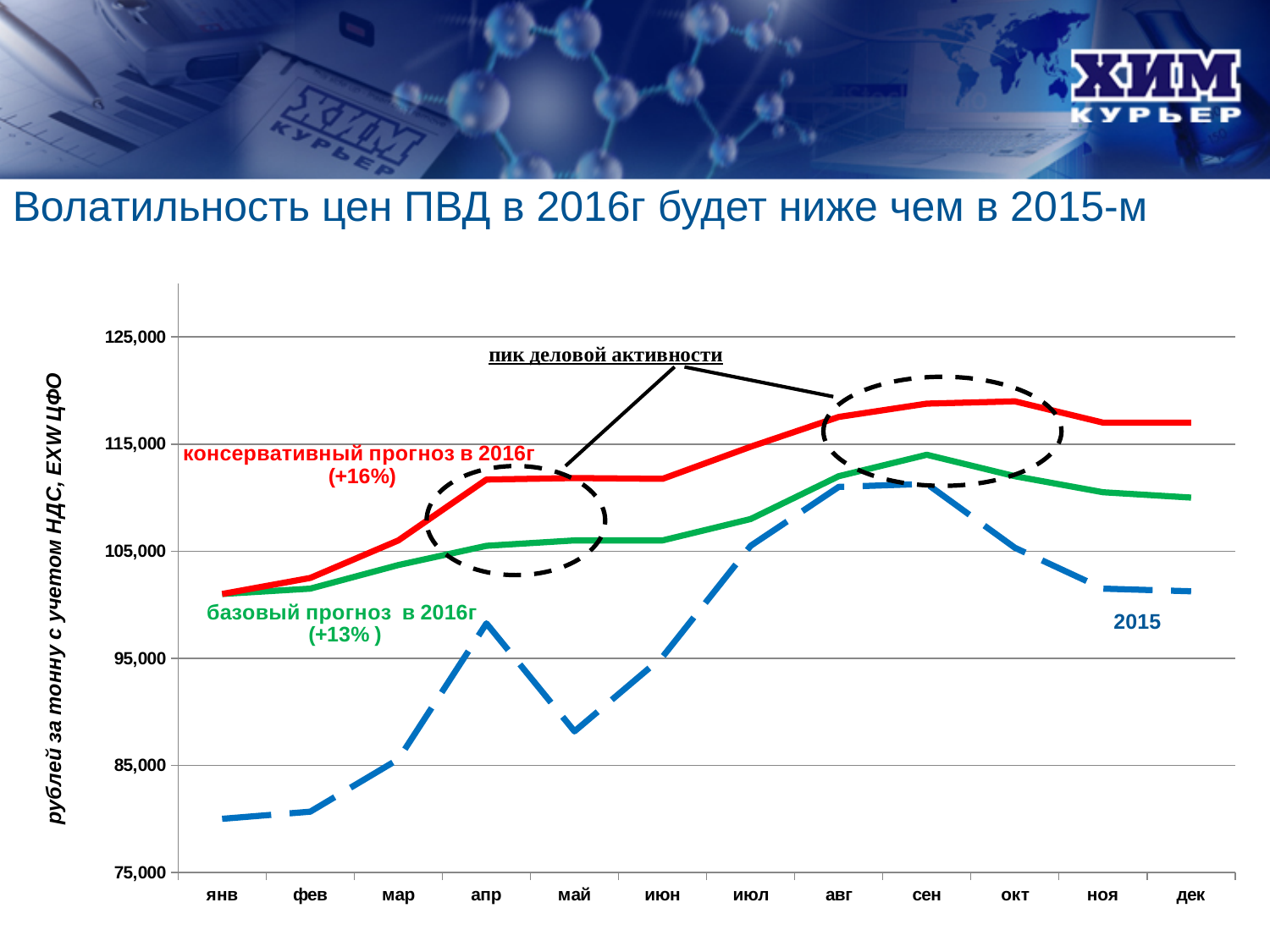
What percentage increase is stated for the консервативный прогноз в 2016г series? +16% Is the value of the 2015 series in янв greater or less than 85,000? less For the 2015 series, which month has the larger value, апр or май? апр Which series has the highest value in дек? консервативный прогноз в 2016г How many months are shown along the x axis of the chart? 12 Does the 2015 series rise or fall from янв to апр? rise Is the value of the конservative forecast (консервативный прогноз в 2016г) in окт greater or less than 115,000? greater How many data series are plotted on the chart? 3 Which series has the lowest value in янв? 2015 What kind of chart is shown on the slide? line chart Is the value of the базовый прогноз в 2016г series in сен greater or less than 105,000? greater